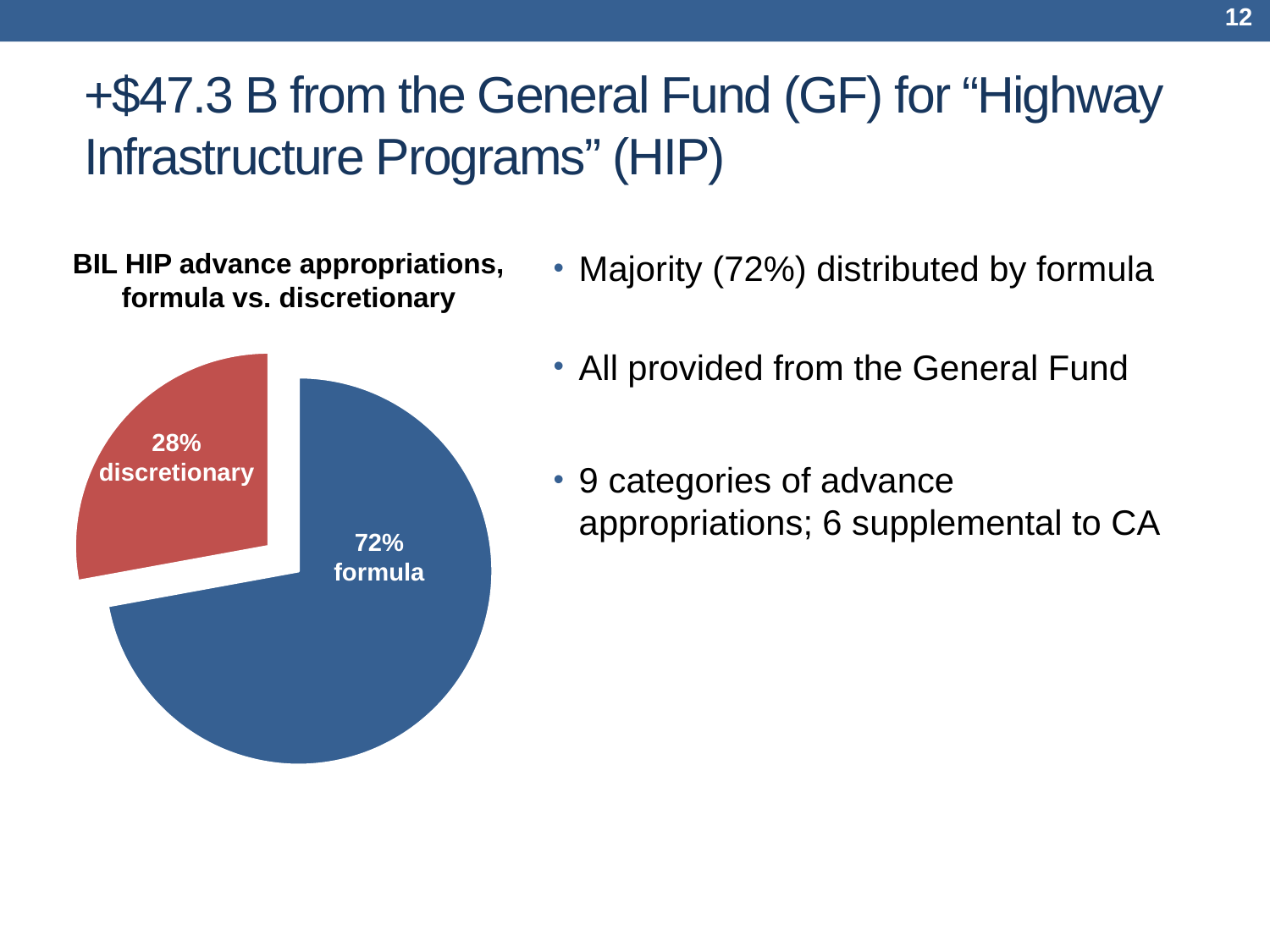
What share of the pie does the formula slice represent? 72% How many slices does the pie chart have? 2 Which slice of the pie is the largest? formula Which is larger, the formula slice or the discretionary slice? formula What colour is the discretionary slice of the pie? Red What is the total of the two slices shown in the pie chart? 100% What is the difference in percentage points between the formula and discretionary slices? 44 What is the title of the pie chart? BIL HIP advance appropriations, formula vs. discretionary Which slice of the pie is the smallest? discretionary What share of the pie does the discretionary slice represent? 28% What kind of chart is shown on the slide? Pie chart